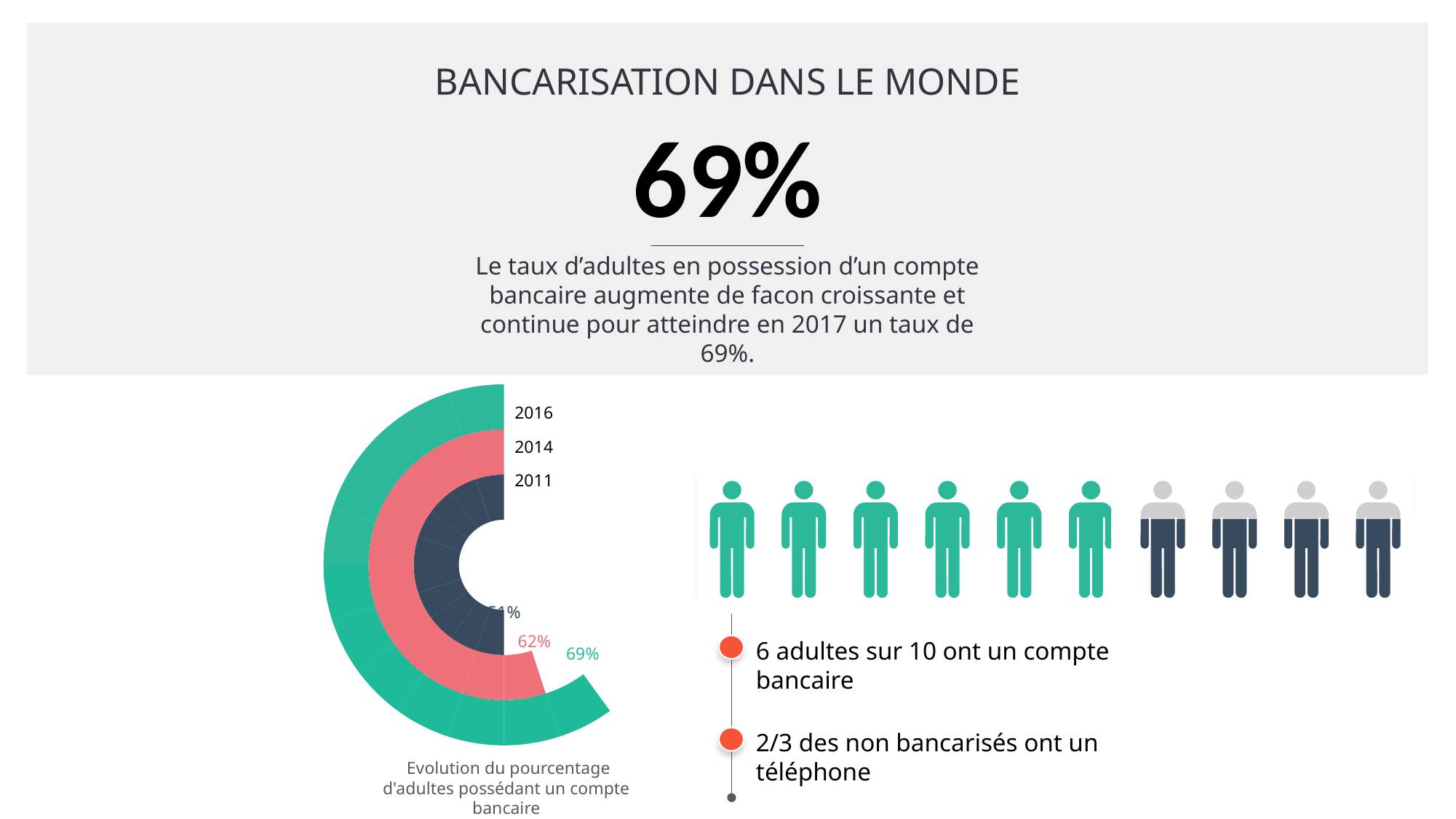
How many years are shown in the ring chart on the left? 3 In the ring chart on the left, which year has the highest percentage? 2016 What kind of chart is shown on the left of the slide? donut chart In the ring chart on the left, what is the difference between the 2016 and 2014 values? 7% In the ring chart on the left, what colour is the ring for 2016? green In the ring chart on the left, do the values rise or fall from 2011 to 2016? rise In the ring chart on the left, what is the value for 2016? 69% What is the caption below the ring chart on the left? Evolution du pourcentage d'adultes possédant un compte bancaire In the ring chart on the left, which year has the larger value, 2014 or 2016? 2016 In the pictogram on the right, how many of the 10 person figures are green? 6 In the ring chart on the left, which year has the lowest percentage? 2011 In the ring chart on the left, what is the value for 2014? 62%